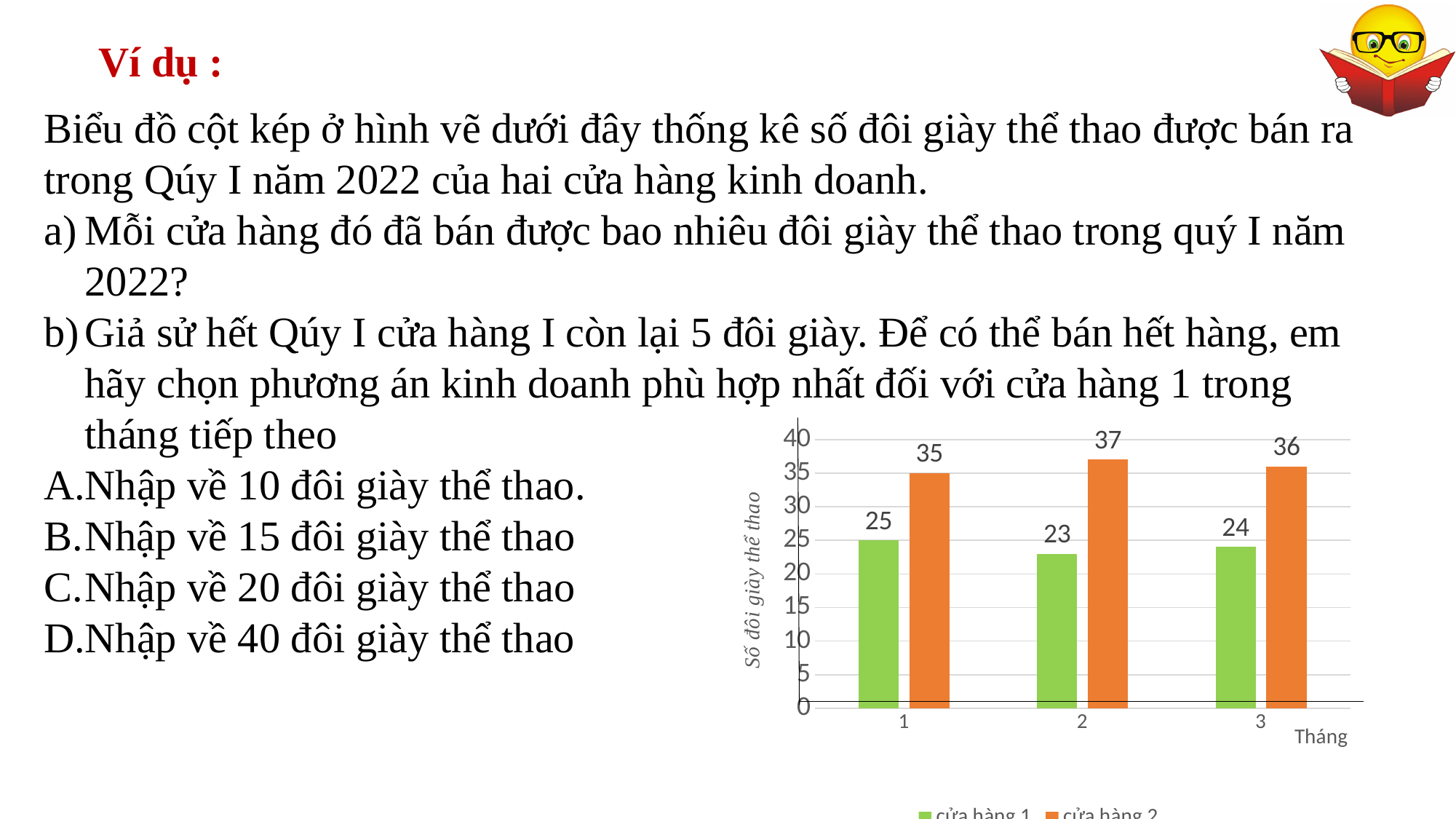
What is the value for cửa hàng 1 in month 1? 25 What is the value for cửa hàng 1 in month 3? 24 Which is larger in month 1: cửa hàng 1 or cửa hàng 2? cửa hàng 2 What kind of chart is shown on the slide? bar chart What is the value for cửa hàng 2 in month 2? 37 How many months are shown on the x axis? 3 What is the label of the vertical axis? Số đôi giày thể thao In which month is the value for cửa hàng 2 highest? 2 How many series does the legend list? 2 In which month is the value for cửa hàng 1 lowest? 2 What is the value for cửa hàng 2 in month 3? 36 What is the difference between cửa hàng 2 and cửa hàng 1 in month 2? 14